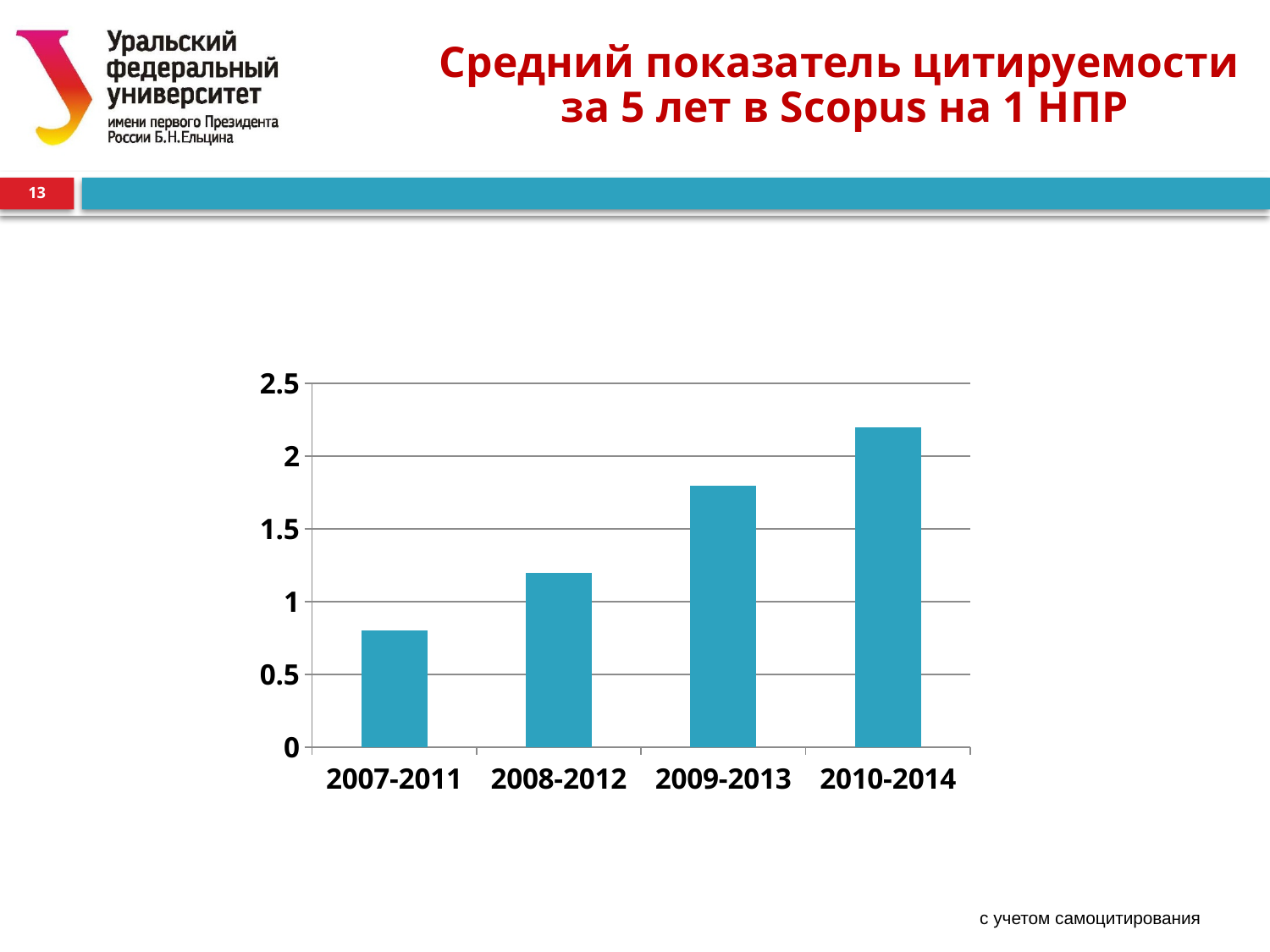
What is the title of the slide containing the chart? Средний показатель цитируемости за 5 лет в Scopus на 1 НПР Is the value for 2007-2011 greater or less than 1? less How many periods (bars) are shown on the chart? 4 Is the value for 2010-2014 greater or less than 2? greater Is the value for 2009-2013 greater or less than 2? less What is the highest value shown on the vertical axis of the chart? 2.5 Do the values rise or fall from 2007-2011 to 2010-2014? rise What kind of chart is shown on the slide? bar chart Which is larger, the value for 2008-2012 or the value for 2009-2013? 2009-2013 Which period has the highest value on the chart? 2010-2014 Which period has the lowest value on the chart? 2007-2011